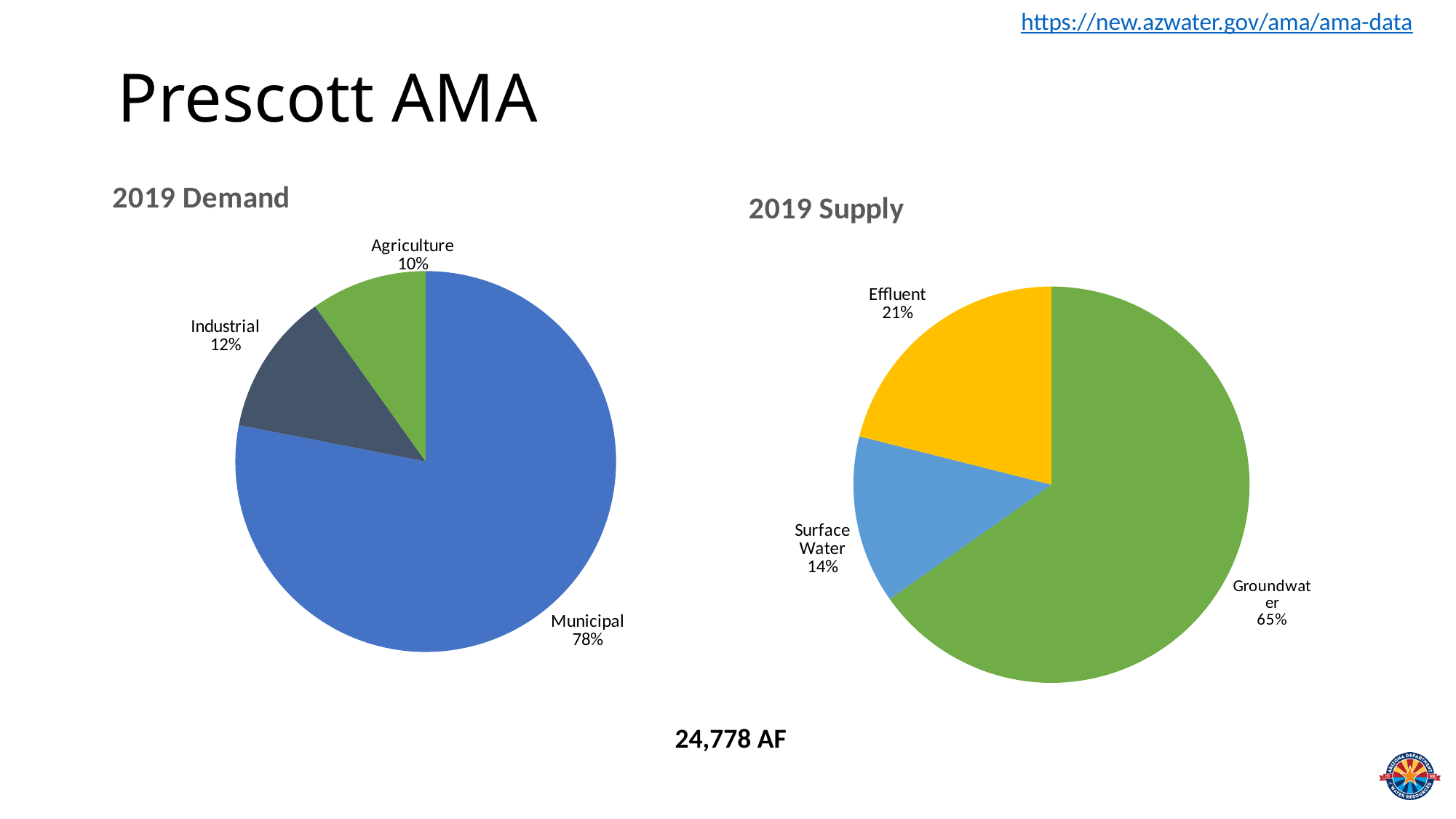
In the 2019 Supply chart, which is larger, Effluent or Surface Water? Effluent In the 2019 Demand chart, what is the value for Agriculture? 10% In the 2019 Demand chart, what is the difference between Municipal and Industrial? 66% What kind of chart is the 2019 Demand chart? Pie chart How many categories are shown in the 2019 Supply chart? 3 In the 2019 Demand chart, what is the value for Industrial? 12% In the 2019 Supply chart, what is the value for Surface Water? 14% In the 2019 Supply chart, what is the value for Effluent? 21% In the 2019 Demand chart, which category has the smallest slice? Agriculture In the 2019 Supply chart, which category has the largest slice? Groundwater In the 2019 Demand chart, what share does Municipal have? 78% In the 2019 Supply chart, what share does Groundwater have? 65%